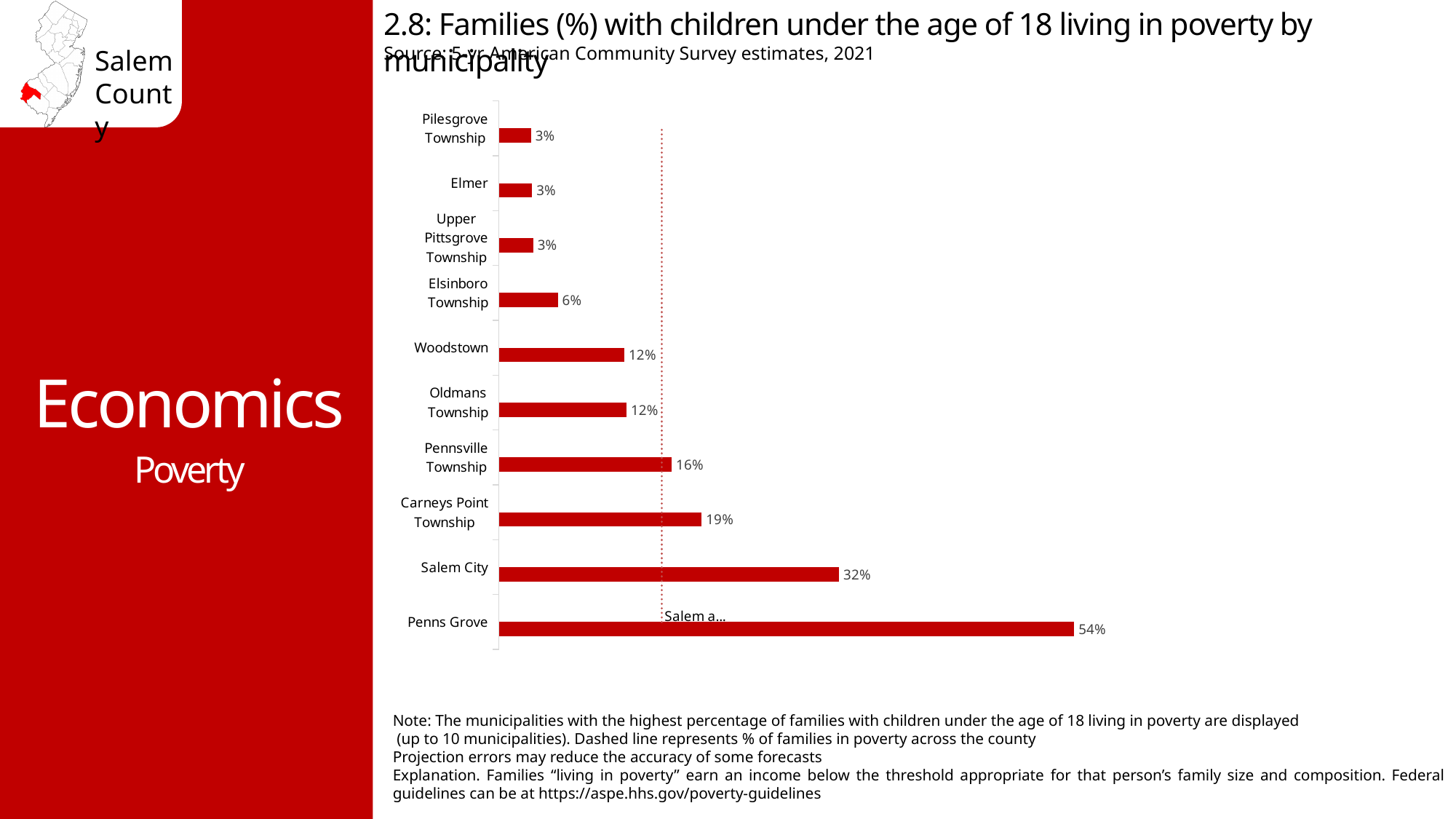
What is the value shown for Elsinboro Township? 6% What is the difference between the values for Penns Grove and Salem City? 22% What is the value shown for Salem City? 32% Which municipality has the highest percentage of families with children under 18 living in poverty? Penns Grove According to the note, what does the dashed line in the chart represent? % of families in poverty across the county What is the value shown for Carneys Point Township? 19% What is the difference between the values for Pennsville Township and Woodstown? 4% What kind of chart is shown on the slide? Bar chart What percentage of families with children under 18 are living in poverty in Penns Grove? 54% How many municipalities are shown in the chart? 10 Which has a larger value, Carneys Point Township or Pennsville Township? Carneys Point Township Which has a larger value, Elsinboro Township or Elmer? Elsinboro Township